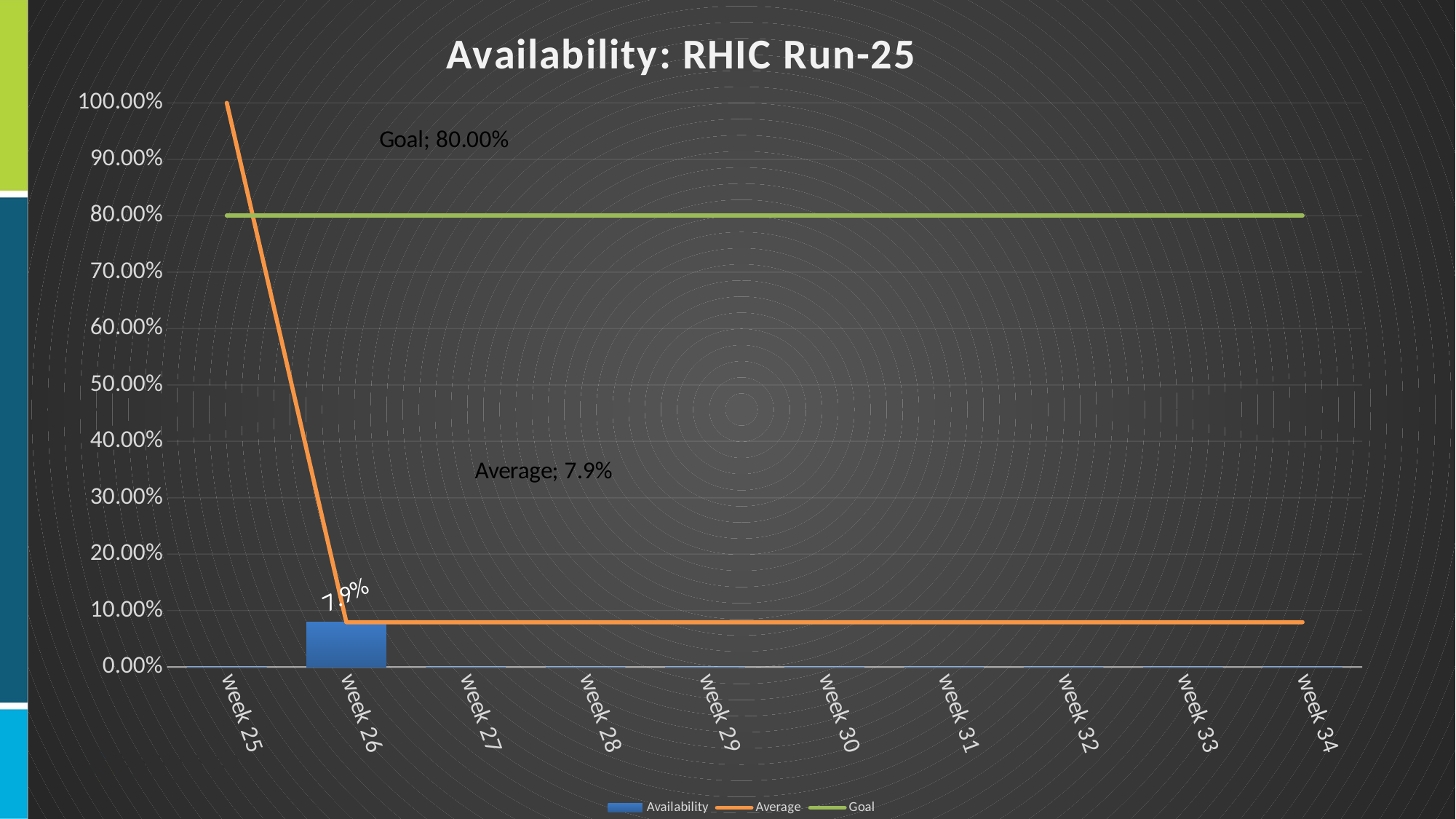
What value is the Goal line set at? 80.00% What is the Average value shown on the chart? 7.9% Is the Availability value for week 26 greater or less than 10.00%? less How many weeks are shown on the x axis? 10 Is the Goal line greater or less than 50.00%? greater Does the Average line rise or fall from week 25 to week 26? fall Which week has the highest Availability bar? week 26 What is the title of the chart? Availability: RHIC Run-25 What is the difference between the Goal value and the Availability value for week 26? 72.1% What is the Availability value for week 26? 7.9% How many series does the legend list? 3 At week 30, which is larger: the Goal line or the Average line? Goal